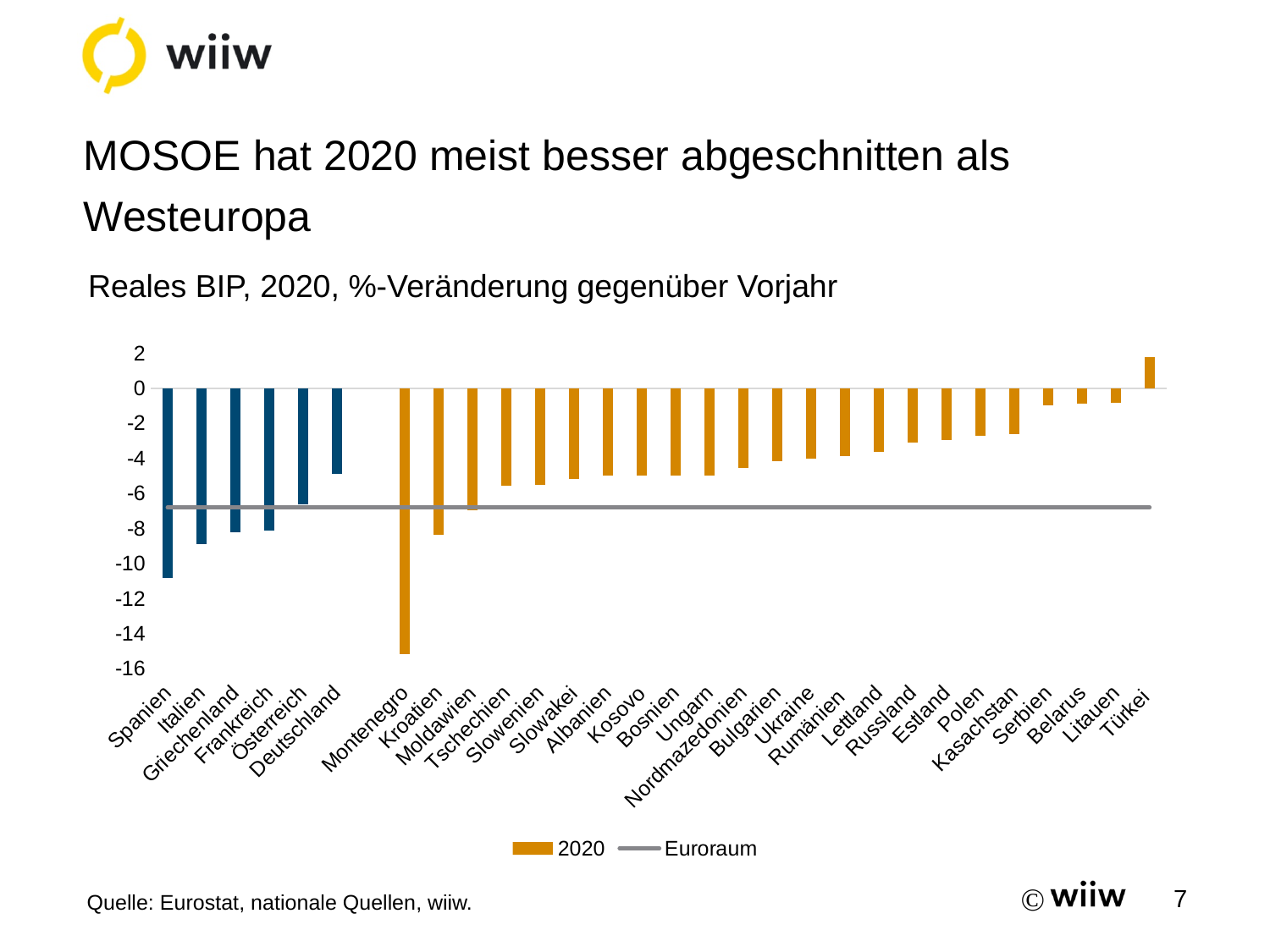
Which country has the lowest value in the chart? Montenegro Is the value for Türkei greater or less than 0? greater Which country has the highest value in the chart? Türkei How many countries are shown on the x axis of the chart? 29 What kind of chart is shown on the slide? bar chart Is the value for Montenegro greater or less than -14? less Is the value for Spanien greater or less than -10? less What are the two entries listed in the chart legend? 2020 and Euroraum How many entries does the chart legend list? 2 Which has the larger value, Deutschland or Frankreich? Deutschland Which has the lower value, Spanien or Italien? Spanien